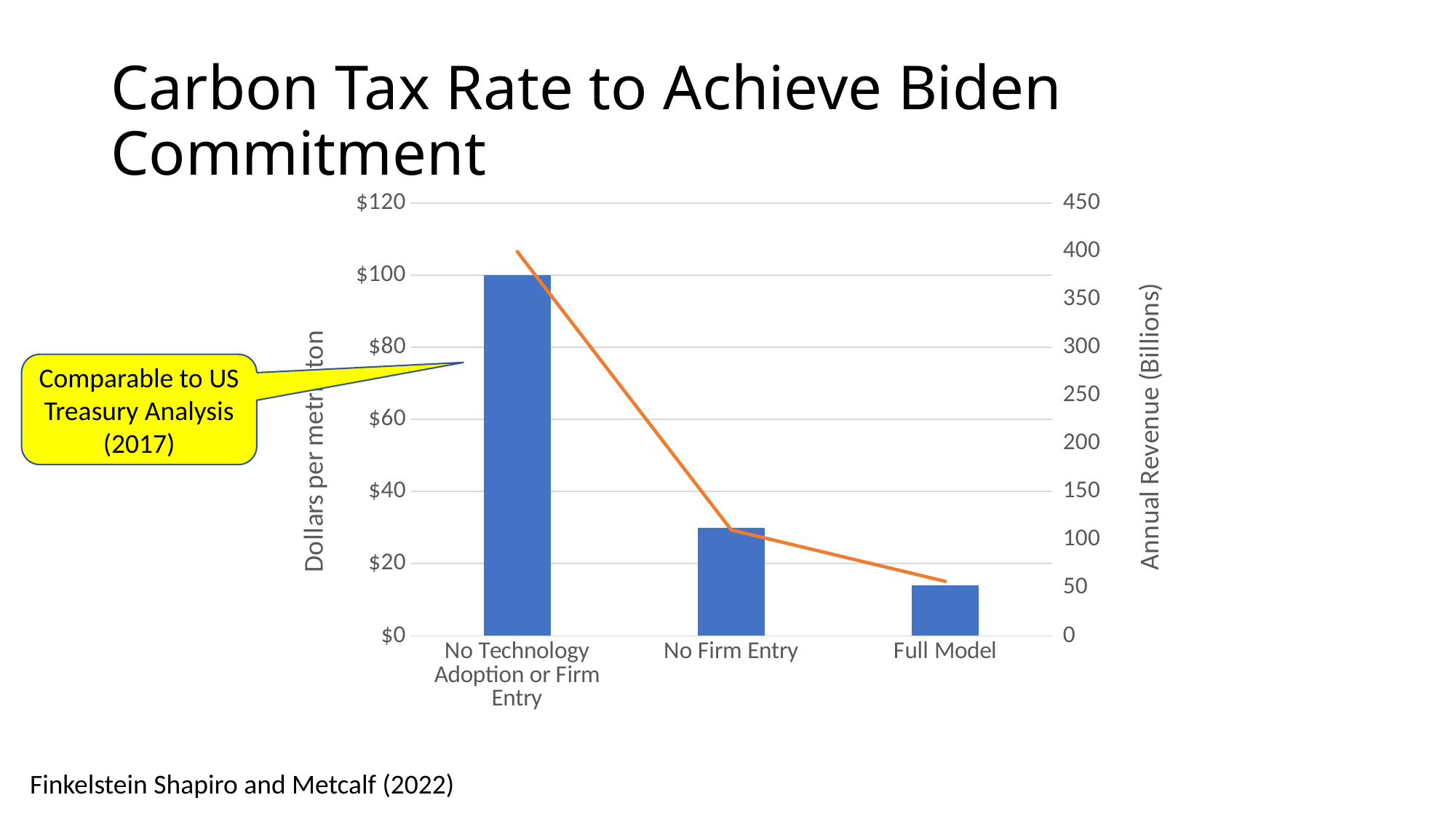
Which category has the highest carbon tax rate bar? No Technology Adoption or Firm Entry Is the carbon tax rate bar for No Firm Entry greater or less than $40? less Is the carbon tax rate bar for Full Model greater or less than $20? less What kind of chart is shown on the slide? bar chart with a line overlay What does the yellow callout on the slide say? Comparable to US Treasury Analysis (2017) What is the label on the right-hand vertical axis? Annual Revenue (Billions) Which category has the lowest carbon tax rate bar? Full Model Which has the larger carbon tax rate bar, No Firm Entry or Full Model? No Firm Entry Is the annual revenue line value for No Technology Adoption or Firm Entry greater or less than 350 billion? greater How many categories are shown on the x axis? 3 What is the carbon tax rate (dollars per metric ton) for No Technology Adoption or Firm Entry? $100 Do the bar values rise or fall moving from left to right along the x axis? fall